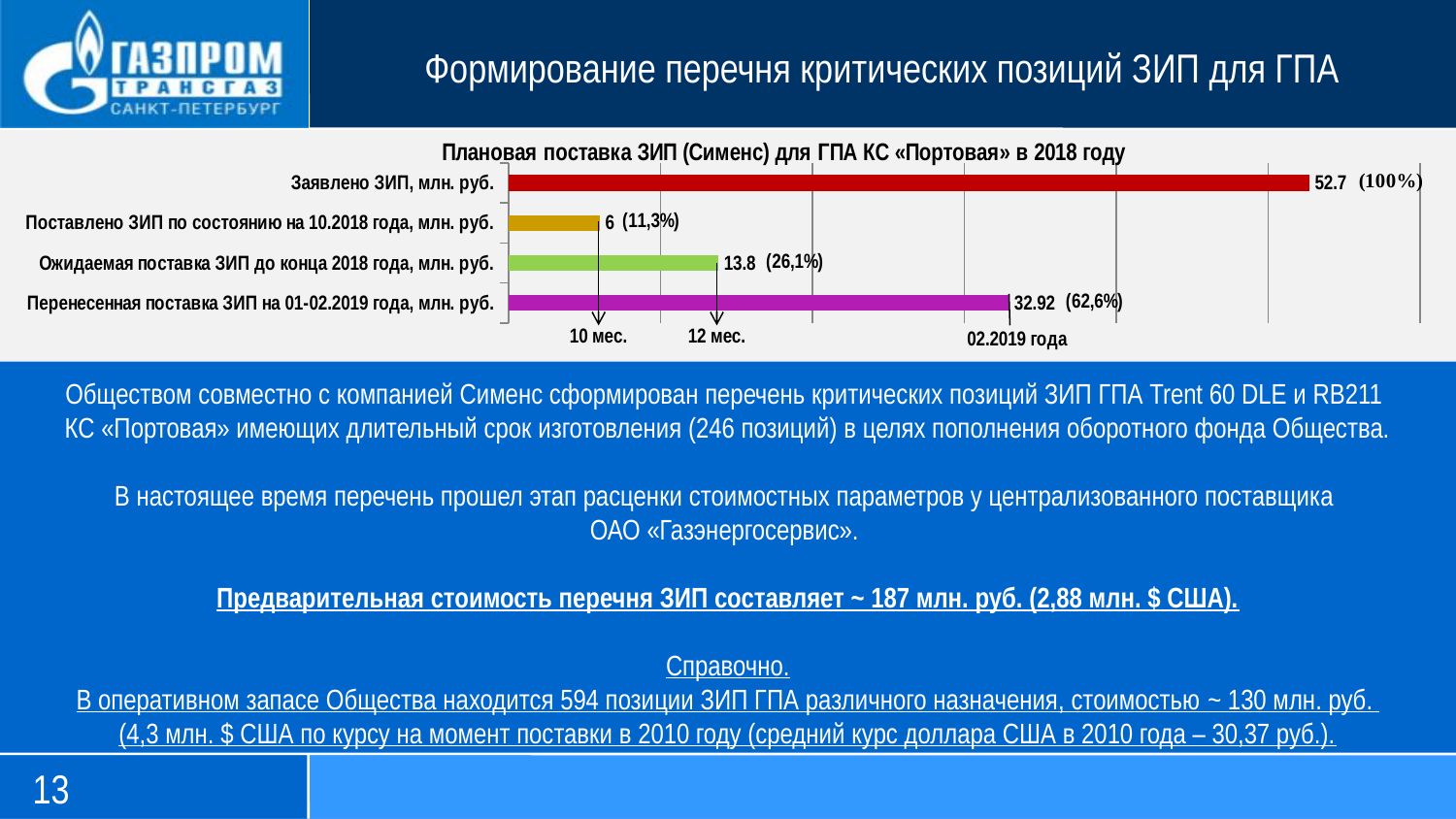
What type of chart is shown on the slide? Bar chart What is the value for «Перенесенная поставка ЗИП на 01-02.2019 года, млн. руб.»? 32.92 What is the value for «Заявлено ЗИП, млн. руб.»? 52.7 What is the difference between the value for «Заявлено ЗИП» and the value for «Перенесенная поставка ЗИП на 01-02.2019 года»? 19.78 How many categories (bars) does the chart show? 4 Which category has the highest value? Заявлено ЗИП, млн. руб. Which is larger: the value for «Ожидаемая поставка ЗИП до конца 2018 года» or the value for «Поставлено ЗИП по состоянию на 10.2018 года»? Ожидаемая поставка ЗИП до конца 2018 года What is the title of the chart? Плановая поставка ЗИП (Сименс) для ГПА КС «Портовая» в 2018 году What percentage is shown next to the bar for «Перенесенная поставка ЗИП на 01-02.2019 года, млн. руб.»? 62,6% What is the value for «Поставлено ЗИП по состоянию на 10.2018 года, млн. руб.»? 6 What is the value for «Ожидаемая поставка ЗИП до конца 2018 года, млн. руб.»? 13.8 Which category has the lowest value? Поставлено ЗИП по состоянию на 10.2018 года, млн. руб.